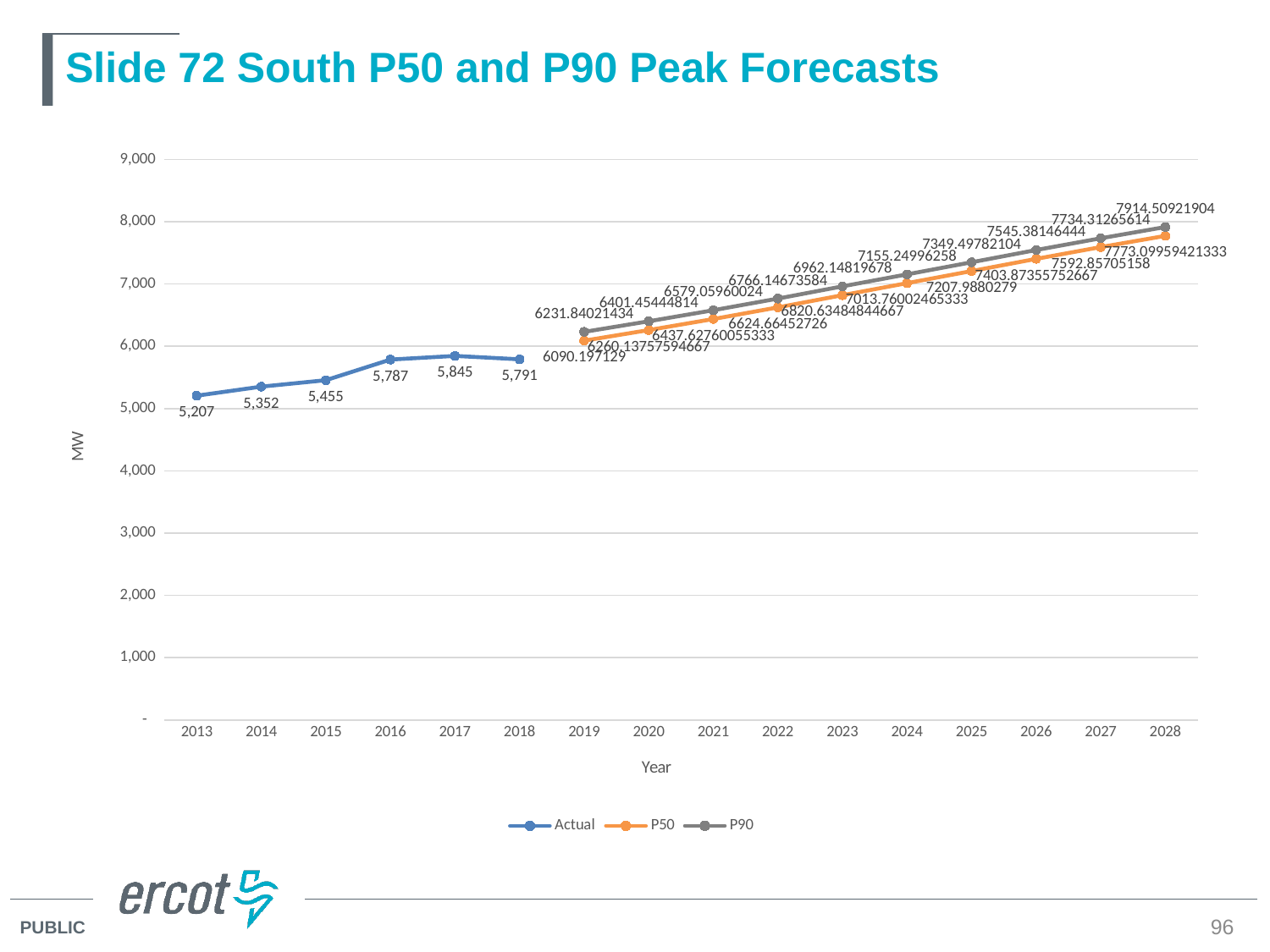
What is the Actual value for 2017? 5,845 Which year has the highest Actual value? 2017 What is the P90 value for 2028? 7914.50921904 What is the P50 value for 2019? 6090.197129 What type of chart is shown on the slide? line chart What is the label on the y axis? MW What is the P90 value for 2019? 6231.84021434 Is the P90 value for 2028 greater or less than 8,000? less What is the difference between the Actual values for 2017 and 2013? 638 Which year has the lowest Actual value? 2013 What is the Actual value for 2013? 5,207 How many series does the legend list? 3